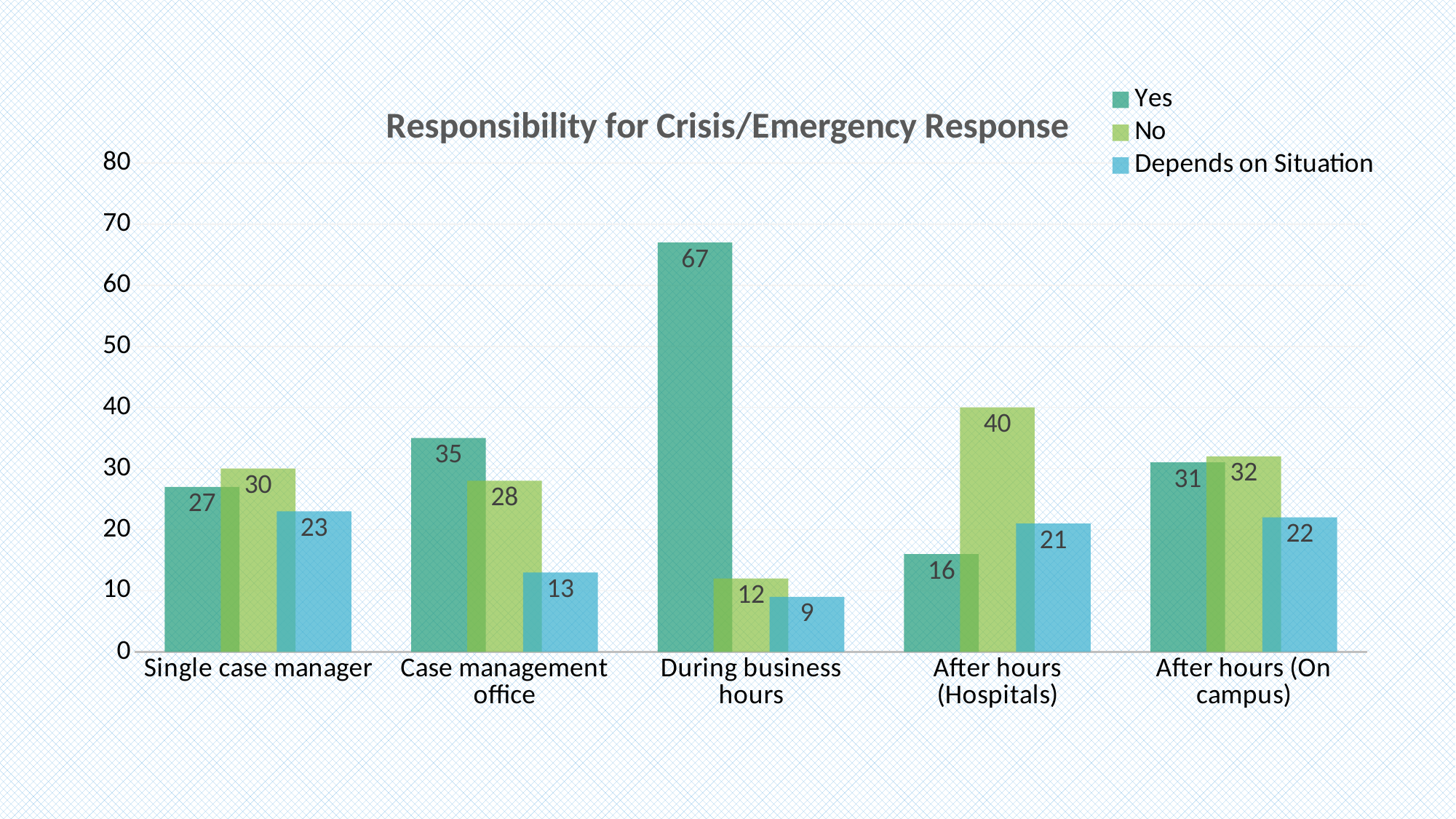
What is the difference between the 'Yes' and 'No' values for 'After hours (Hospitals)'? 24 Which is larger for 'Single case manager': the 'Yes' value or the 'No' value? No What is the 'No' value for 'After hours (Hospitals)'? 40 Which category has the highest 'Yes' value? During business hours What is the 'Yes' value for 'During business hours'? 67 Which category has the lowest 'Depends on Situation' value? During business hours Is the 'Yes' value for 'Case management office' greater or less than 30? greater What is the 'Depends on Situation' value for 'Case management office'? 13 How many series does the legend list? 3 What is the title of the chart? Responsibility for Crisis/Emergency Response How many categories are shown on the x axis? 5 What kind of chart is shown on the slide? Bar chart